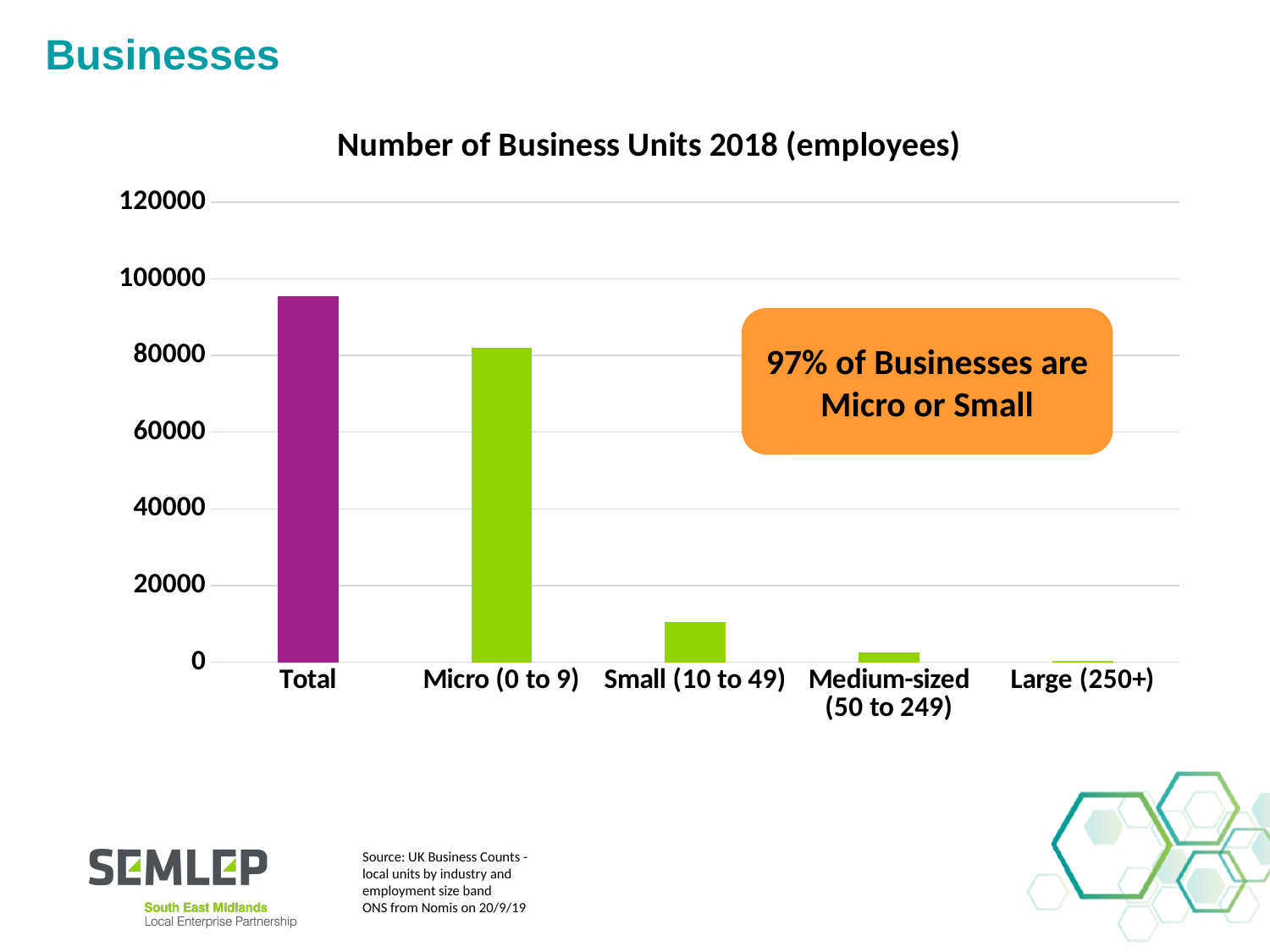
Is the value for Small (10 to 49) greater or less than 20000? less Which category has the tallest bar? Total Do the bar values rise or fall moving from left to right along the x axis? fall Which is larger, the value for Micro (0 to 9) or the value for Small (10 to 49)? Micro (0 to 9) How many categories are shown on the x axis of the chart? 5 Is the value for Medium-sized (50 to 249) greater or less than 20000? less Which category has the shortest bar? Large (250+) Is the value for Total greater or less than 100000? less What type of chart is shown on the slide? Bar chart What is the title of the chart? Number of Business Units 2018 (employees) What percentage of businesses does the callout box say are Micro or Small? 97%